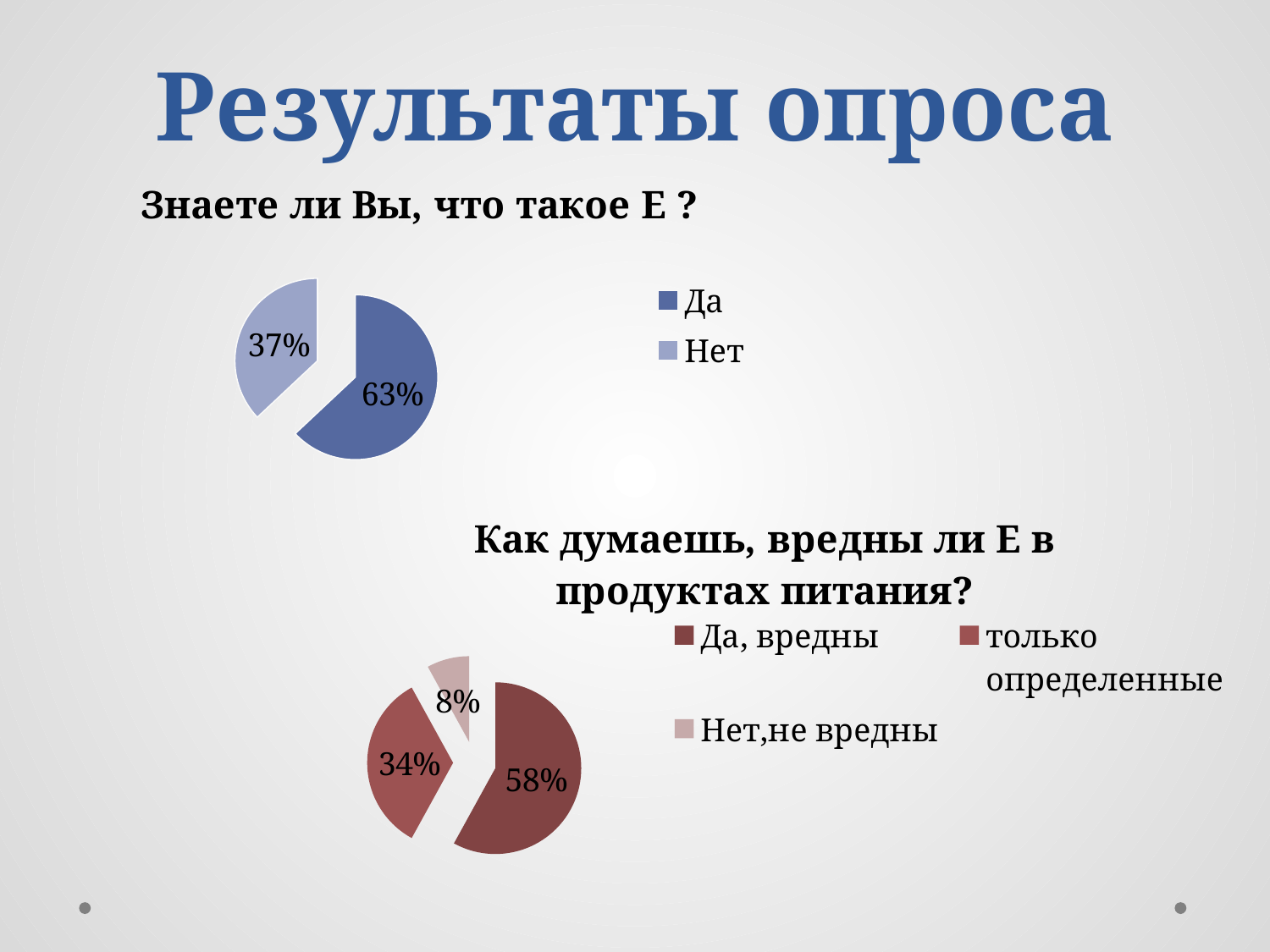
In the bottom chart 'Как думаешь, вредны ли Е в продуктах питания?', what is the difference in percentage points between 'Да, вредны' and 'только определенные'? 24 In the top chart 'Знаете ли Вы, что такое Е ?', what share of respondents answered 'Нет'? 37% In the top chart 'Знаете ли Вы, что такое Е ?', what share of respondents answered 'Да'? 63% What kind of chart is the top chart 'Знаете ли Вы, что такое Е ?'? Pie chart In the bottom chart 'Как думаешь, вредны ли Е в продуктах питания?', how many slices does the pie have? 3 In the top chart 'Знаете ли Вы, что такое Е ?', which answer has the larger share? Да In the bottom chart 'Как думаешь, вредны ли Е в продуктах питания?', what share answered 'Нет,не вредны'? 8% In the bottom chart 'Как думаешь, вредны ли Е в продуктах питания?', what share answered 'только определенные'? 34% How many entries does the legend of the top chart 'Знаете ли Вы, что такое Е ?' list? 2 In the bottom chart 'Как думаешь, вредны ли Е в продуктах питания?', what share answered 'Да, вредны'? 58% In the top chart 'Знаете ли Вы, что такое Е ?', what is the difference in percentage points between 'Да' and 'Нет'? 26 In the bottom chart 'Как думаешь, вредны ли Е в продуктах питания?', which answer has the smallest share? Нет,не вредны